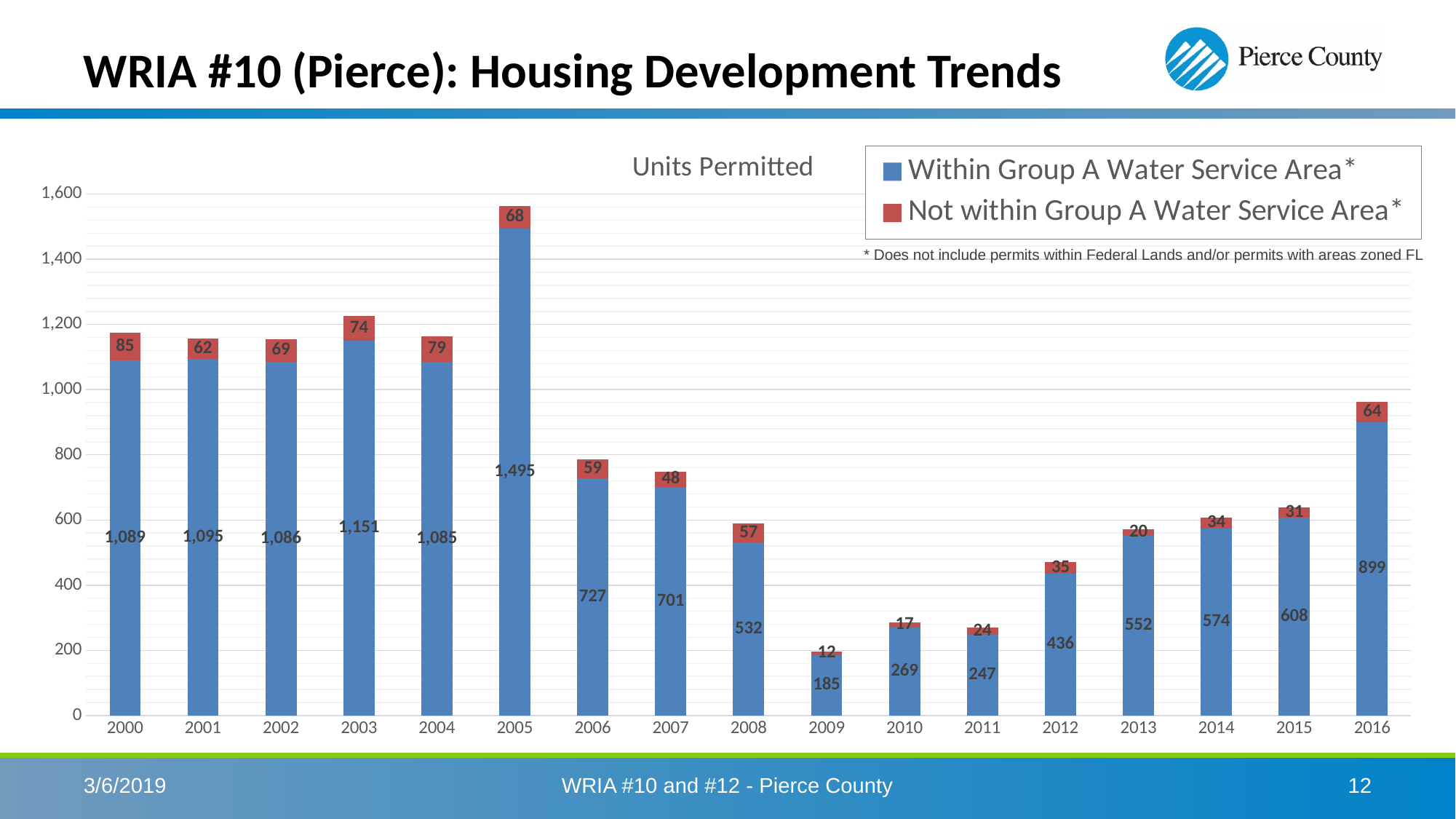
What is the difference between the Within Group A Water Service Area values for 2015 and 2014? 34 What is the value for Not within Group A Water Service Area in 2009? 12 How many years are shown on the x axis? 17 What is the value for Within Group A Water Service Area in 2005? 1,495 What is the total of the stacked bar for 2016? 963 Is the total stacked bar for 2012 greater or less than 400? greater How many series does the legend list? 2 What type of chart is shown on the slide? Stacked bar chart What is the title of the chart? Units Permitted Which year has the highest value for Within Group A Water Service Area? 2005 Which year has the lowest value for Within Group A Water Service Area? 2009 Which is larger, the Within Group A Water Service Area value for 2006 or for 2007? 2006